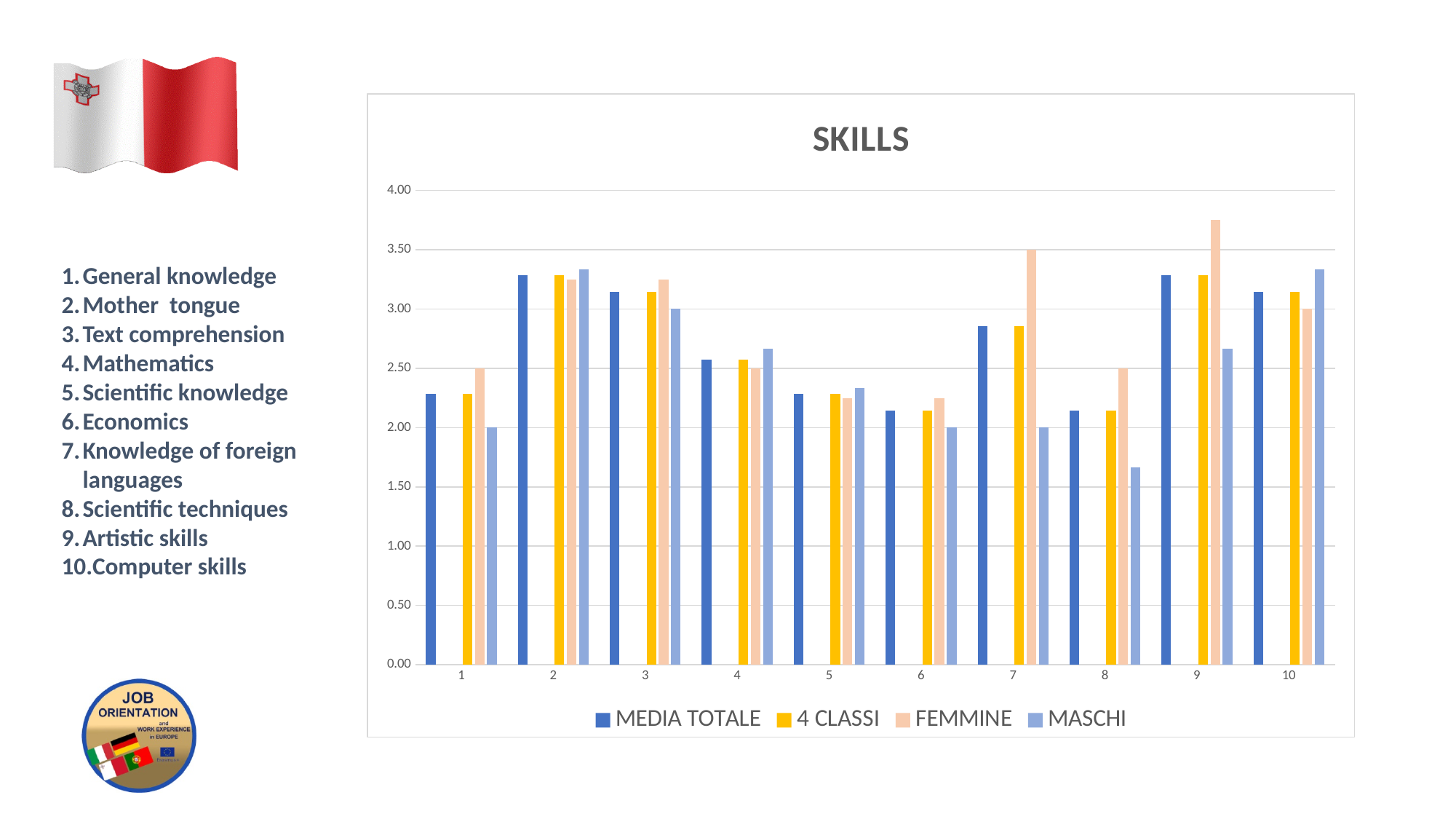
How many series does the chart legend list? 4 How many categories are shown along the x axis of the chart? 10 Is the MASCHI value for category 8 greater or less than 2.00? less Is the MEDIA TOTALE value for category 2 greater or less than 3.00? greater What is the title of the chart? SKILLS For which category is the MASCHI value lowest? 8 For category 7, which is larger: the FEMMINE value or the MASCHI value? FEMMINE For category 9, which is larger: the 4 CLASSI value or the MASCHI value? 4 CLASSI Is the MEDIA TOTALE value for category 7 greater or less than 2.50? greater What kind of chart is shown on the slide? bar chart For which category is the FEMMINE value highest? 9